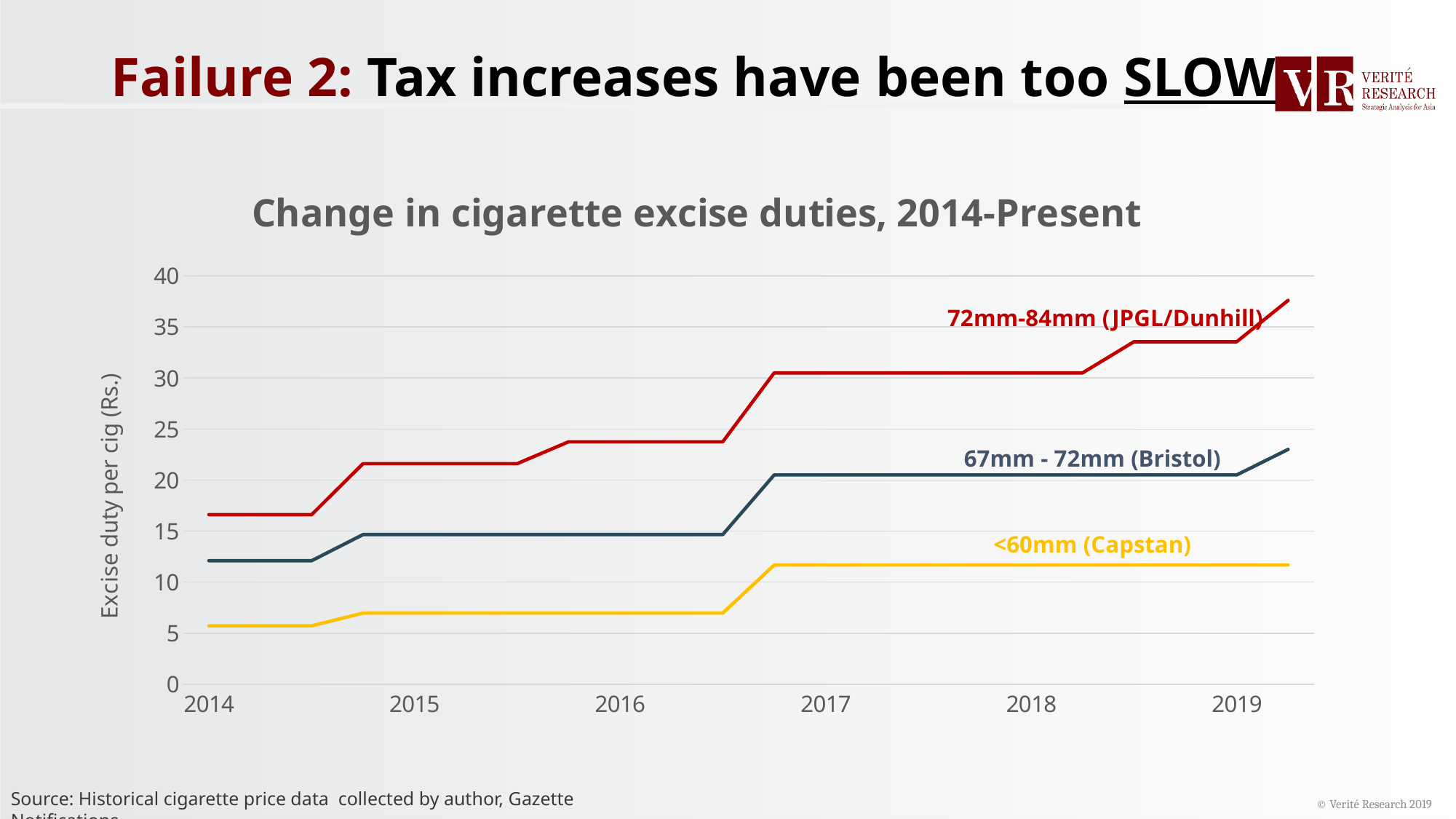
Which series has the highest excise duty throughout the period? 72mm-84mm (JPGL/Dunhill) Which series has the lowest excise duty throughout the period? <60mm (Capstan) Is the excise duty for <60mm (Capstan) in 2014 greater or less than 10? less In 2017, which is larger: the excise duty for 67mm - 72mm (Bristol) or for <60mm (Capstan)? 67mm - 72mm (Bristol) What is the label of the vertical axis? Excise duty per cig (Rs.) Is the excise duty for 72mm-84mm (JPGL/Dunhill) in 2016 greater or less than 25? less What kind of chart is shown on the slide? line chart How many series are plotted on the chart? 3 Is the excise duty for 72mm-84mm (JPGL/Dunhill) in 2014 greater or less than 15? greater What is the title of the chart? Change in cigarette excise duties, 2014-Present Does the excise duty for 67mm - 72mm (Bristol) rise or fall from 2014 to 2019? rise